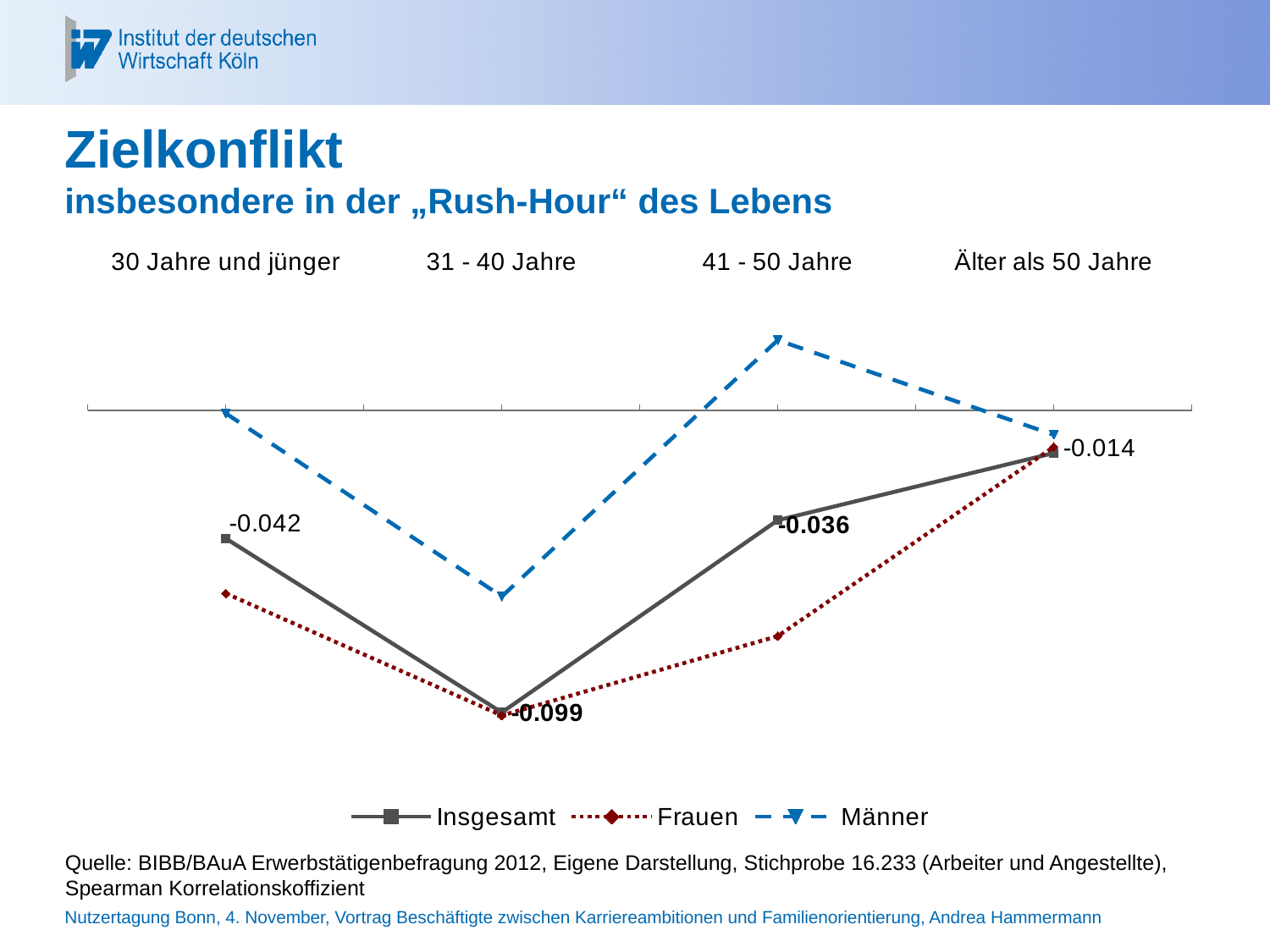
In which age group is the Insgesamt value highest? Älter als 50 Jahre What is the value for Insgesamt in the category 41 - 50 Jahre? -0.036 What kind of chart is shown on the slide? Line chart In which age group is the Insgesamt value lowest? 31 - 40 Jahre How many age categories are shown on the x axis? 4 Which series has the higher value in the category 41 - 50 Jahre, Männer or Frauen? Männer What is the difference between the Insgesamt values for 30 Jahre und jünger and 31 - 40 Jahre? 0.057 Does the Insgesamt line rise or fall from 31 - 40 Jahre to Älter als 50 Jahre? Rise What is the value for Insgesamt in the category 30 Jahre und jünger? -0.042 How many series does the legend list? 3 What is the value for Insgesamt in the category Älter als 50 Jahre? -0.014 What is the value for Insgesamt in the category 31 - 40 Jahre? -0.099